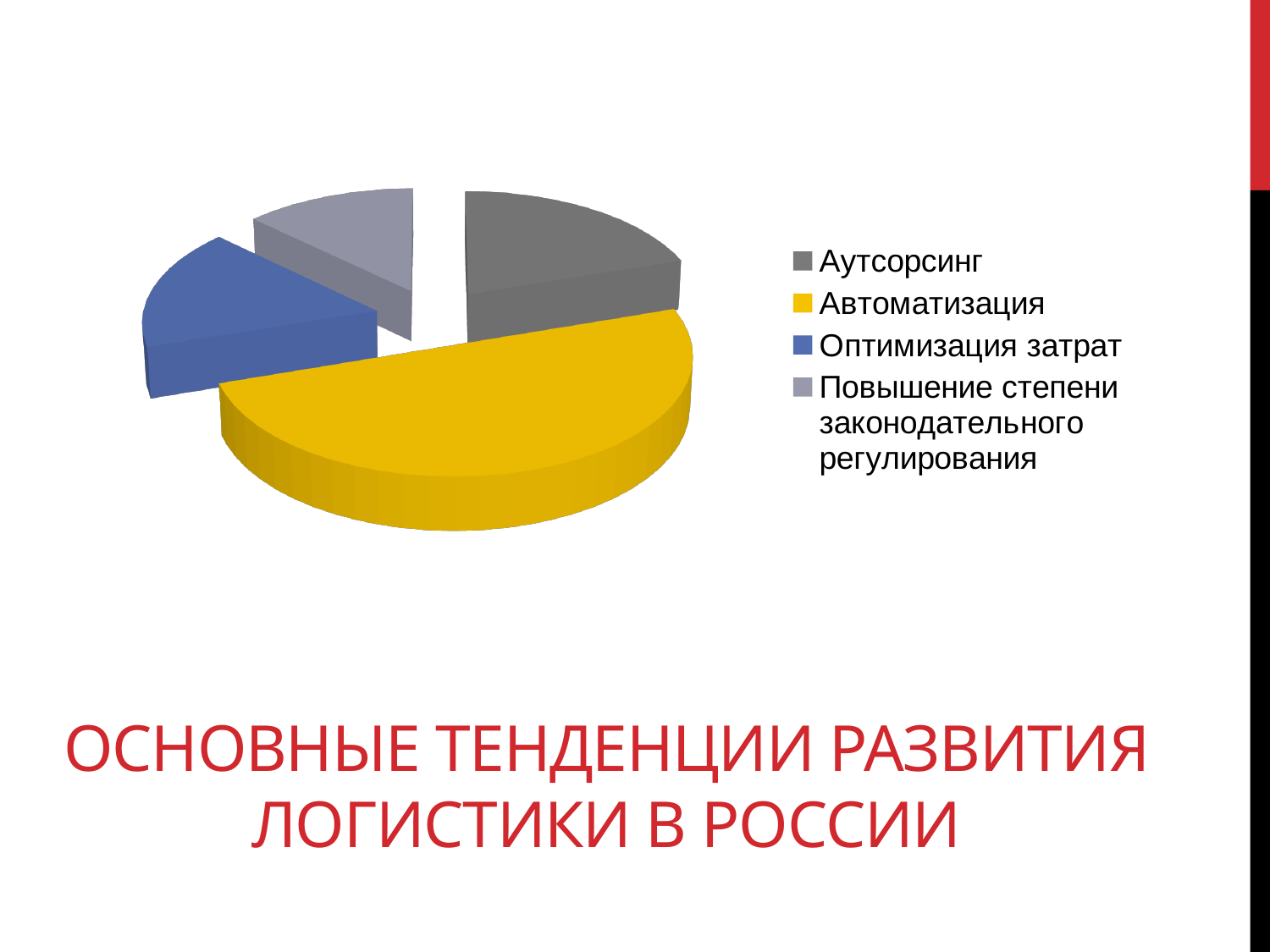
Which slice is larger: Автоматизация or Оптимизация затрат? Автоматизация Which category has the smallest slice in the pie chart? Повышение степени законодательного регулирования Which category has the largest slice in the pie chart? Автоматизация What colour is the Оптимизация затрат slice in the pie chart? blue How many entries does the legend of the pie chart list? 4 What colour is the Автоматизация slice in the pie chart? yellow Which slice is larger: Автоматизация or Аутсорсинг? Автоматизация How many slices does the pie chart have? 4 Which slice is larger: Аутсорсинг or Повышение степени законодательного регулирования? Аутсорсинг What kind of chart is shown on the slide? pie chart